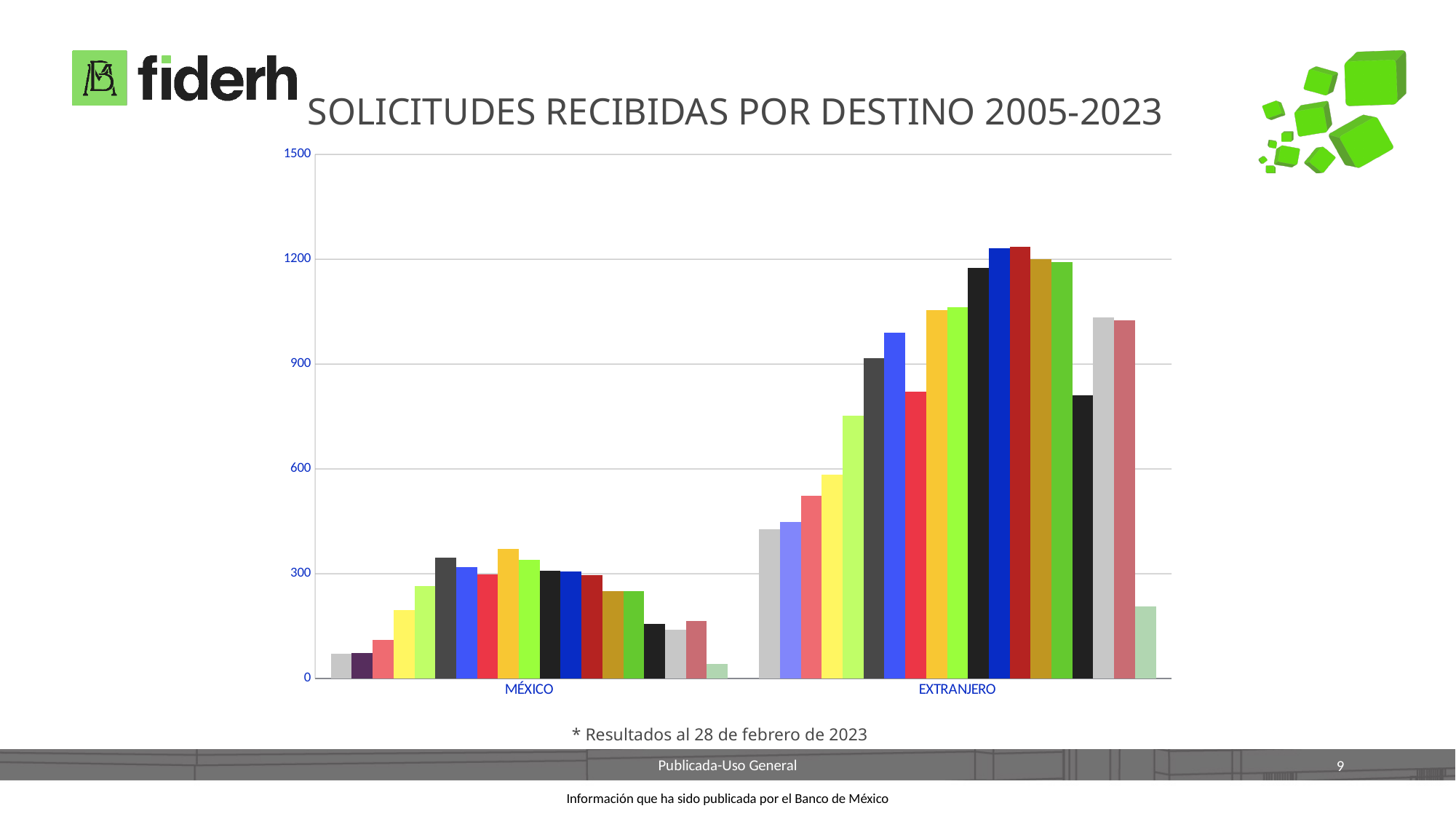
Which category contains the bar with the lowest value in the chart? MÉXICO Which category has the taller tallest bar, MÉXICO or EXTRANJERO? EXTRANJERO Is the value of the leftmost bar in the MÉXICO group greater or less than 300? less Is the value of the leftmost bar in the EXTRANJERO group greater or less than 300? greater Is the value of the tallest bar in the MÉXICO group greater or less than 300? greater How many categories are shown on the x axis of the chart? 2 What is the highest value shown on the vertical axis of the chart? 1500 How many bars are in the MÉXICO group? 19 What kind of chart is shown on the slide? bar chart What is the title of the chart? SOLICITUDES RECIBIDAS POR DESTINO 2005-2023